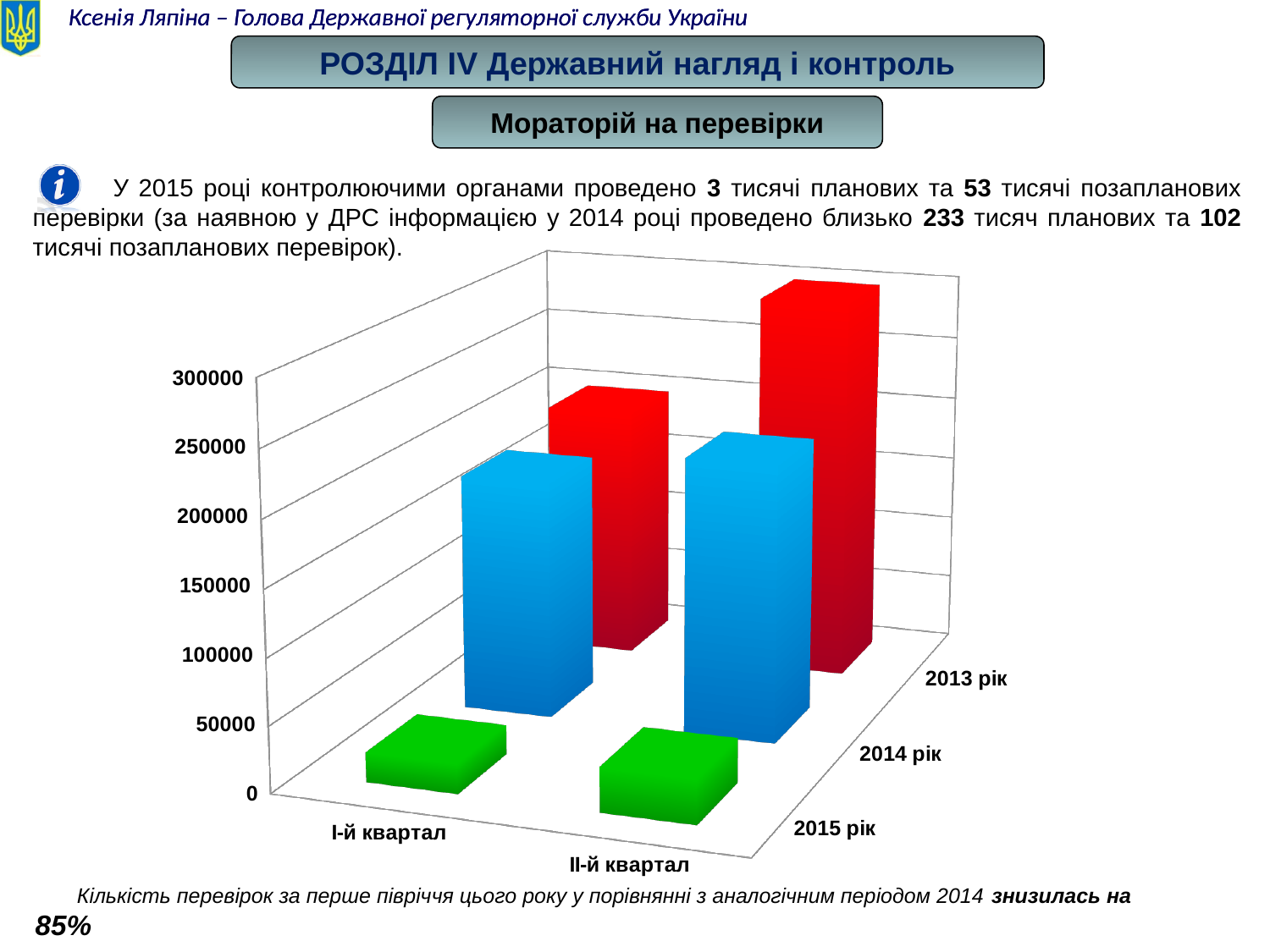
Is the value for 2013 рік in II-й квартал greater or less than 200000? greater How many quarter categories are shown on the chart's x axis? 2 Is the value for 2014 рік in I-й квартал greater or less than 100000? greater Which is larger for II-й квартал: the value for 2014 рік or the value for 2015 рік? 2014 рік Which year has the lowest value for I-й квартал? 2015 рік How many year series are plotted on the chart? 3 Which year has the highest value for II-й квартал? 2013 рік What colour are the bars for 2015 рік? green Which is larger for I-й квартал: the value for 2013 рік or the value for 2015 рік? 2013 рік Does the value for 2013 рік rise or fall from I-й квартал to II-й квартал? rise Is the value for 2015 рік in I-й квартал greater or less than 50000? less What kind of chart is shown on the slide? bar chart